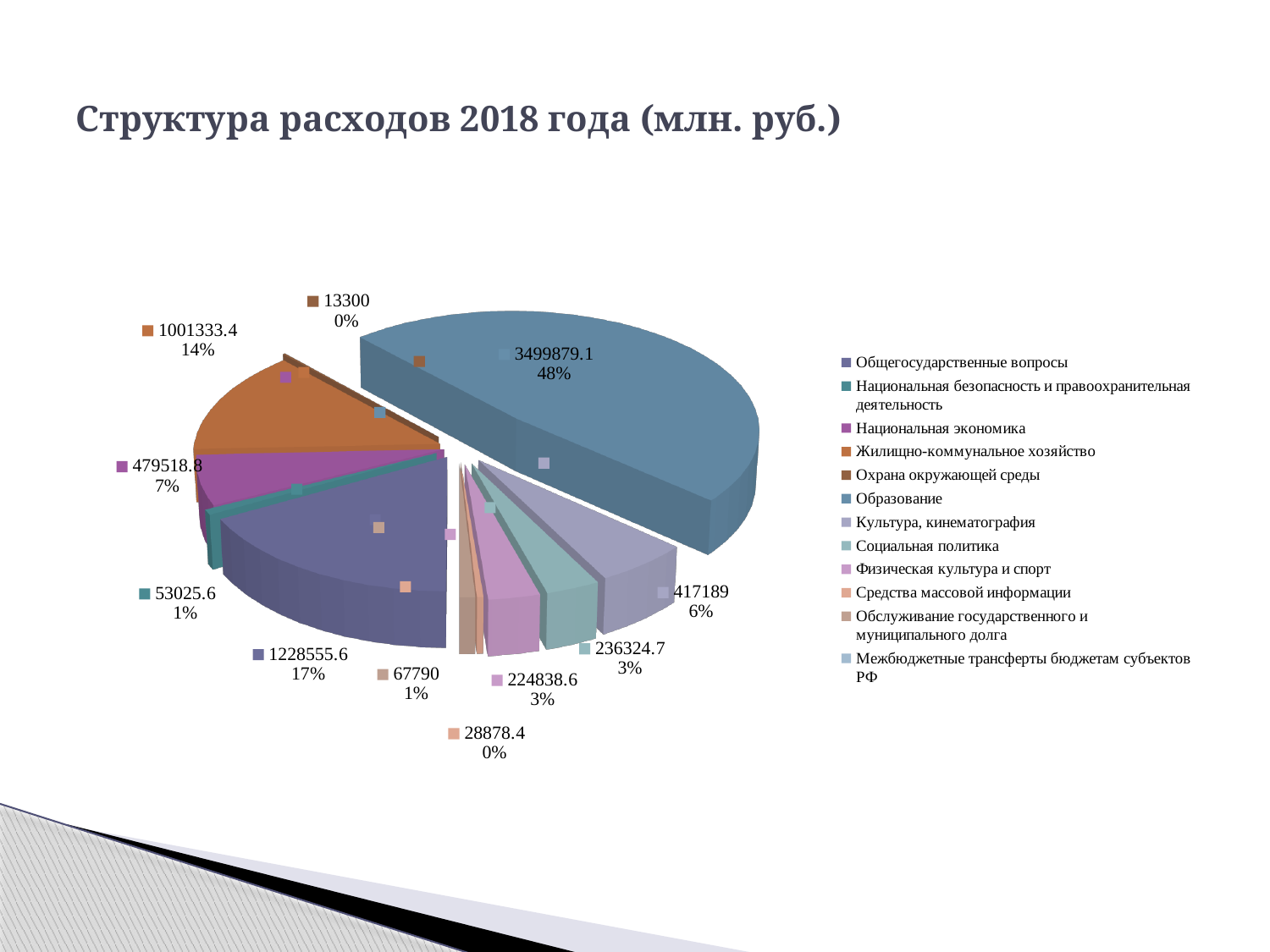
How many entries does the chart legend list? 12 What kind of chart is shown on the slide? pie chart Which is larger, the value for Жилищно-коммунальное хозяйство or the value for Национальная экономика? Жилищно-коммунальное хозяйство What is the title of the chart? Структура расходов 2018 года (млн. руб.) Which category has the largest share of the pie? Образование What share of the pie does Образование account for? 48% What percentage is shown for Национальная экономика? 7% What is the value shown for Жилищно-коммунальное хозяйство? 1001333.4 What is the value shown for Культура, кинематография? 417189 What is the value shown for Охрана окружающей среды? 13300 What is the difference between the values for Образование and Общегосударственные вопросы? 2271323.5 What is the value shown for Общегосударственные вопросы? 1228555.6